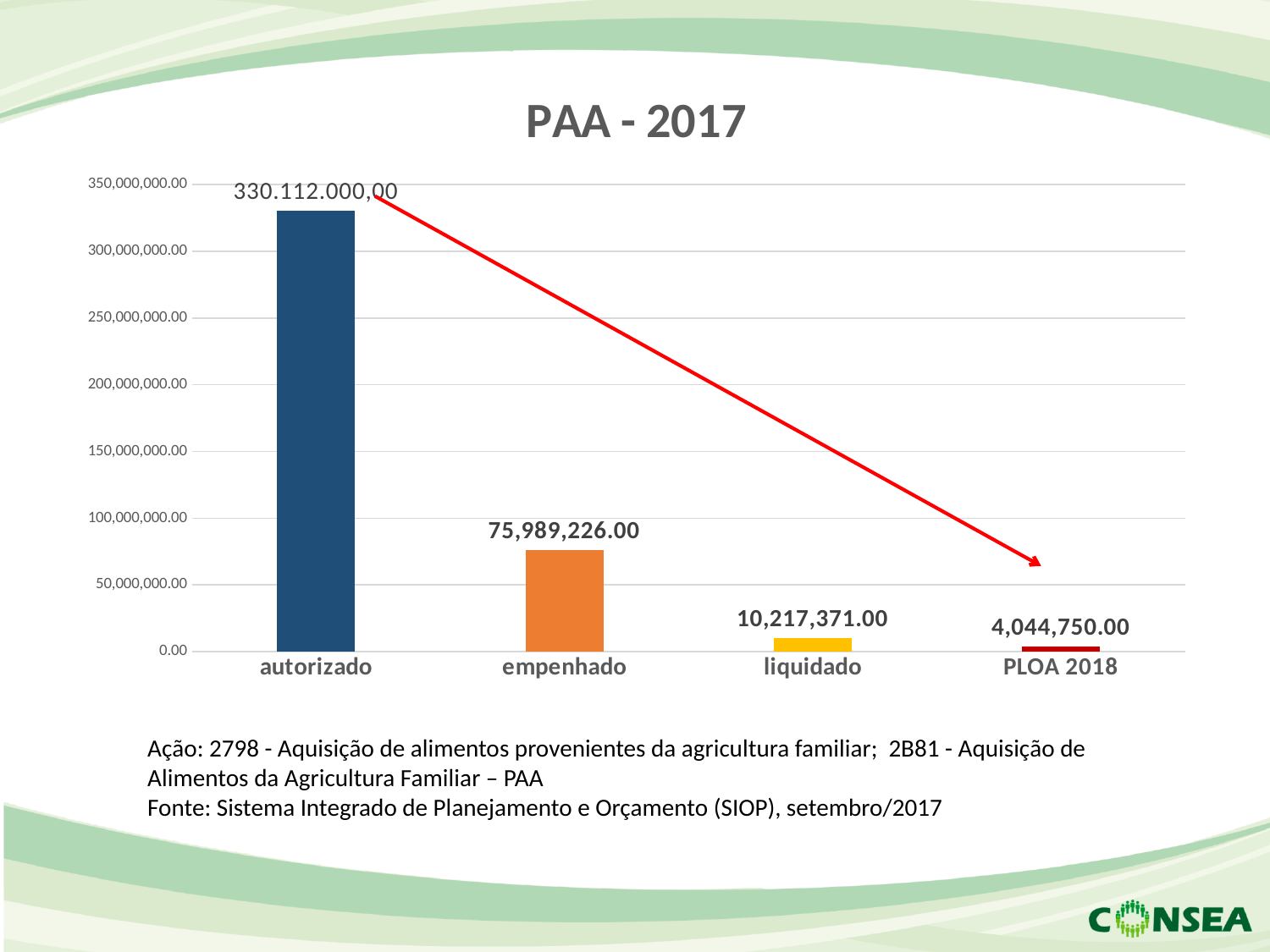
Which category has the highest value? autorizado What is the value for liquidado? 10,217,371.00 What kind of chart is shown on the slide? bar chart What is the difference between the values for liquidado and PLOA 2018? 6,172,621.00 Which is larger, the value for empenhado or the value for liquidado? empenhado What is the value for empenhado? 75,989,226.00 What is the difference between the values for empenhado and liquidado? 65,771,855.00 How many categories are shown on the x axis? 4 Which category has the lowest value? PLOA 2018 What is the value for PLOA 2018? 4,044,750.00 What is the value shown for autorizado? 330.112.000,00 Is the value for autorizado greater or less than 300,000,000.00? greater